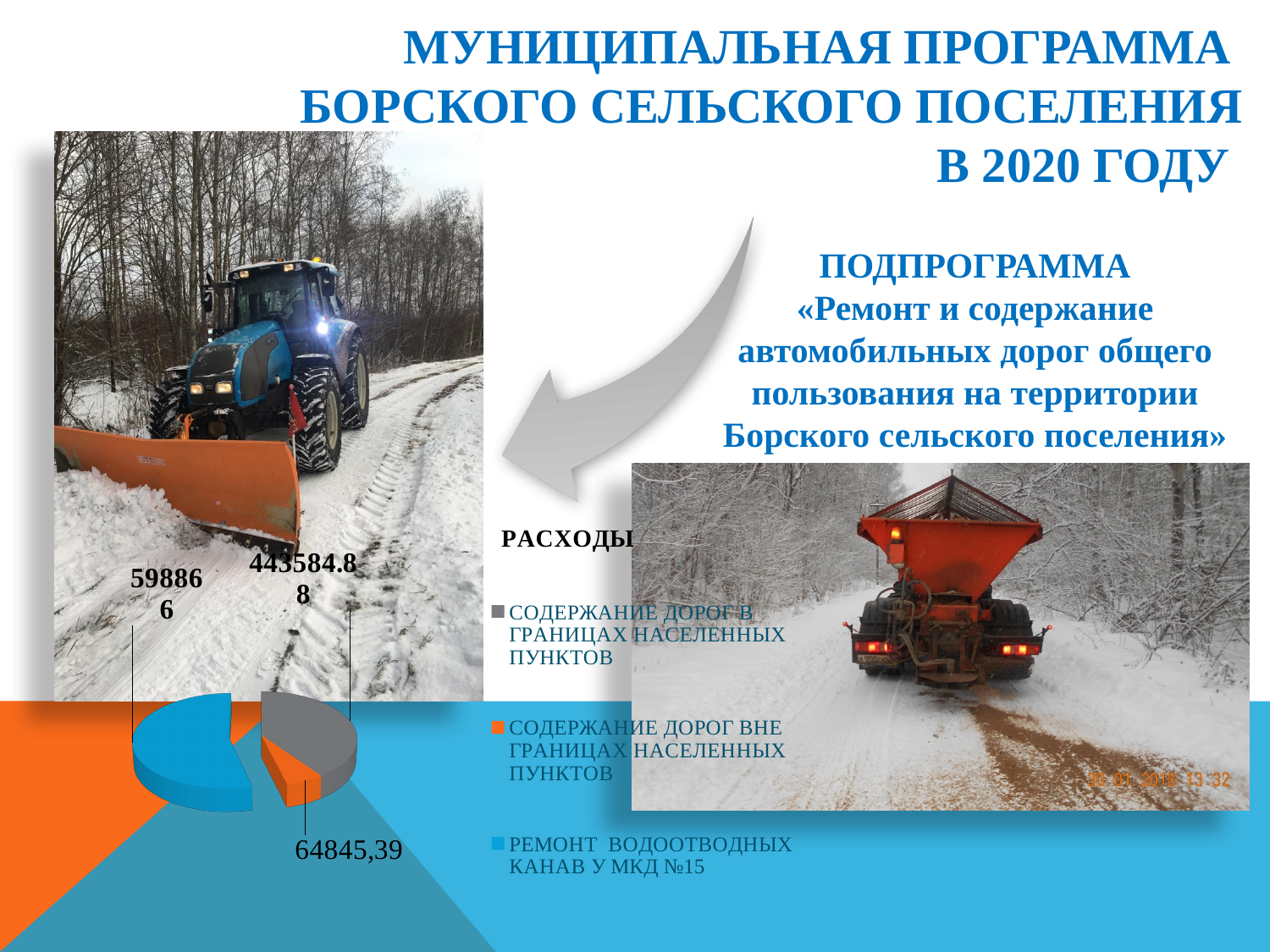
How many entries does the legend of the pie chart list? 3 What is the value shown for the slice 'СОДЕРЖАНИЕ ДОРОГ В ГРАНИЦАХ НАСЕЛЕННЫХ ПУНКТОВ'? 598866 Which category has the smallest slice in the pie chart? СОДЕРЖАНИЕ ДОРОГ ВНЕ ГРАНИЦАХ НАСЕЛЕННЫХ ПУНКТОВ What is the value shown for the slice 'СОДЕРЖАНИЕ ДОРОГ ВНЕ ГРАНИЦАХ НАСЕЛЕННЫХ ПУНКТОВ'? 64845,39 How many slices does the pie chart have? 3 What is the value shown for the slice 'РЕМОНТ ВОДООТВОДНЫХ КАНАВ У МКД №15'? 443584.88 Which is larger: the slice for 'РЕМОНТ ВОДООТВОДНЫХ КАНАВ У МКД №15' or the slice for 'СОДЕРЖАНИЕ ДОРОГ ВНЕ ГРАНИЦАХ НАСЕЛЕННЫХ ПУНКТОВ'? РЕМОНТ ВОДООТВОДНЫХ КАНАВ У МКД №15 Which category has the largest slice in the pie chart? СОДЕРЖАНИЕ ДОРОГ В ГРАНИЦАХ НАСЕЛЕННЫХ ПУНКТОВ What kind of chart is shown on the slide? pie chart What colour is the largest slice of the pie chart? blue What colour is the slice for 'СОДЕРЖАНИЕ ДОРОГ ВНЕ ГРАНИЦАХ НАСЕЛЕННЫХ ПУНКТОВ'? orange